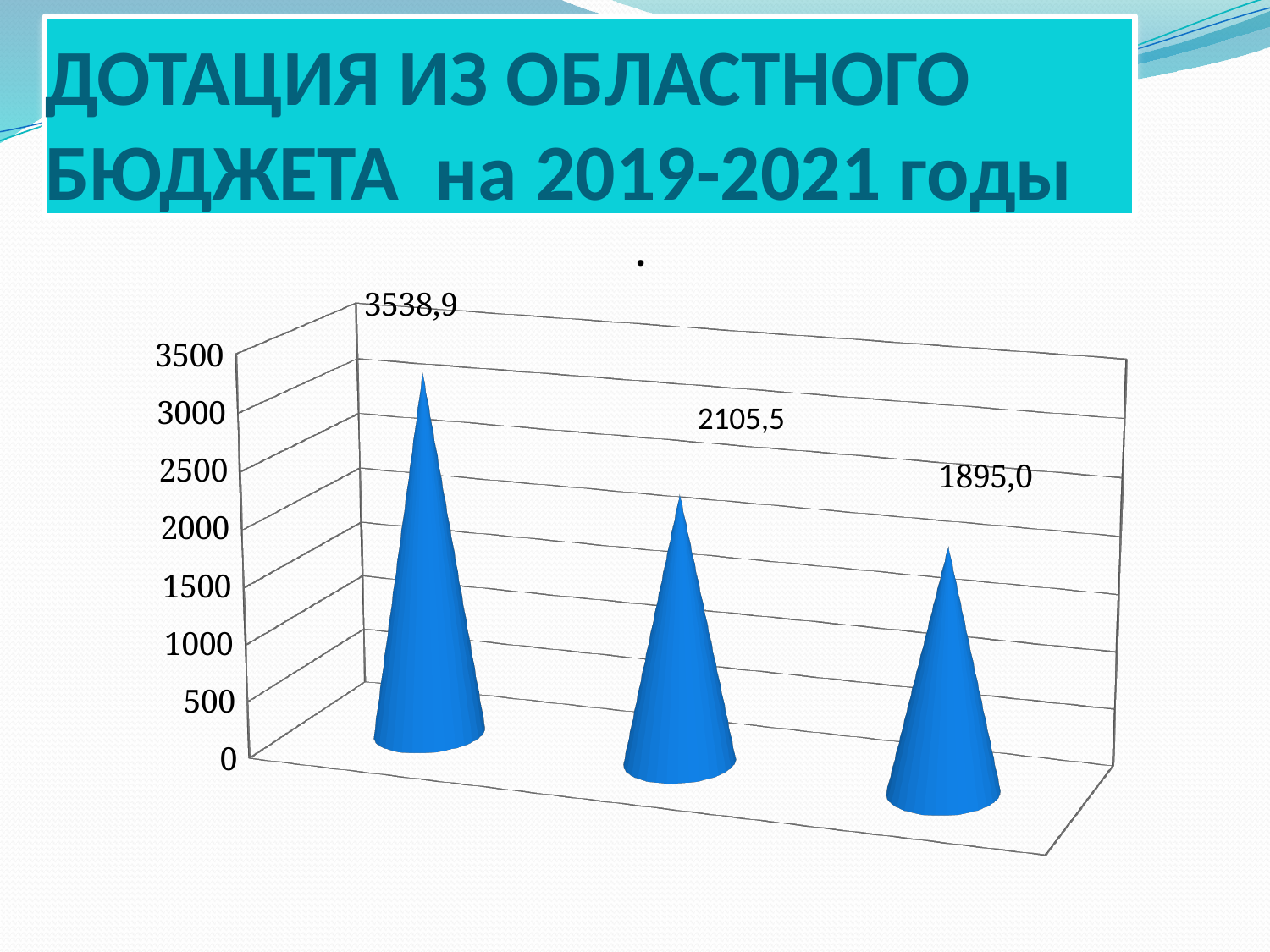
What is the value shown for the leftmost bar? 3538,9 Which bar has the lowest value? The rightmost bar (1895,0) What is the value shown for the rightmost bar? 1895,0 Do the values rise or fall from left to right across the chart? Fall What is the difference between the middle bar and the rightmost bar? 210,5 What kind of chart is shown on the slide? Bar chart What is the difference between the leftmost bar and the middle bar? 1433,4 Which bar has the highest value? The leftmost bar (3538,9) How many bars are plotted on the chart? 3 What is the value shown for the middle bar? 2105,5 Which is larger, the value of the middle bar or the rightmost bar? The middle bar What is the title of the slide? ДОТАЦИЯ ИЗ ОБЛАСТНОГО БЮДЖЕТА на 2019-2021 годы